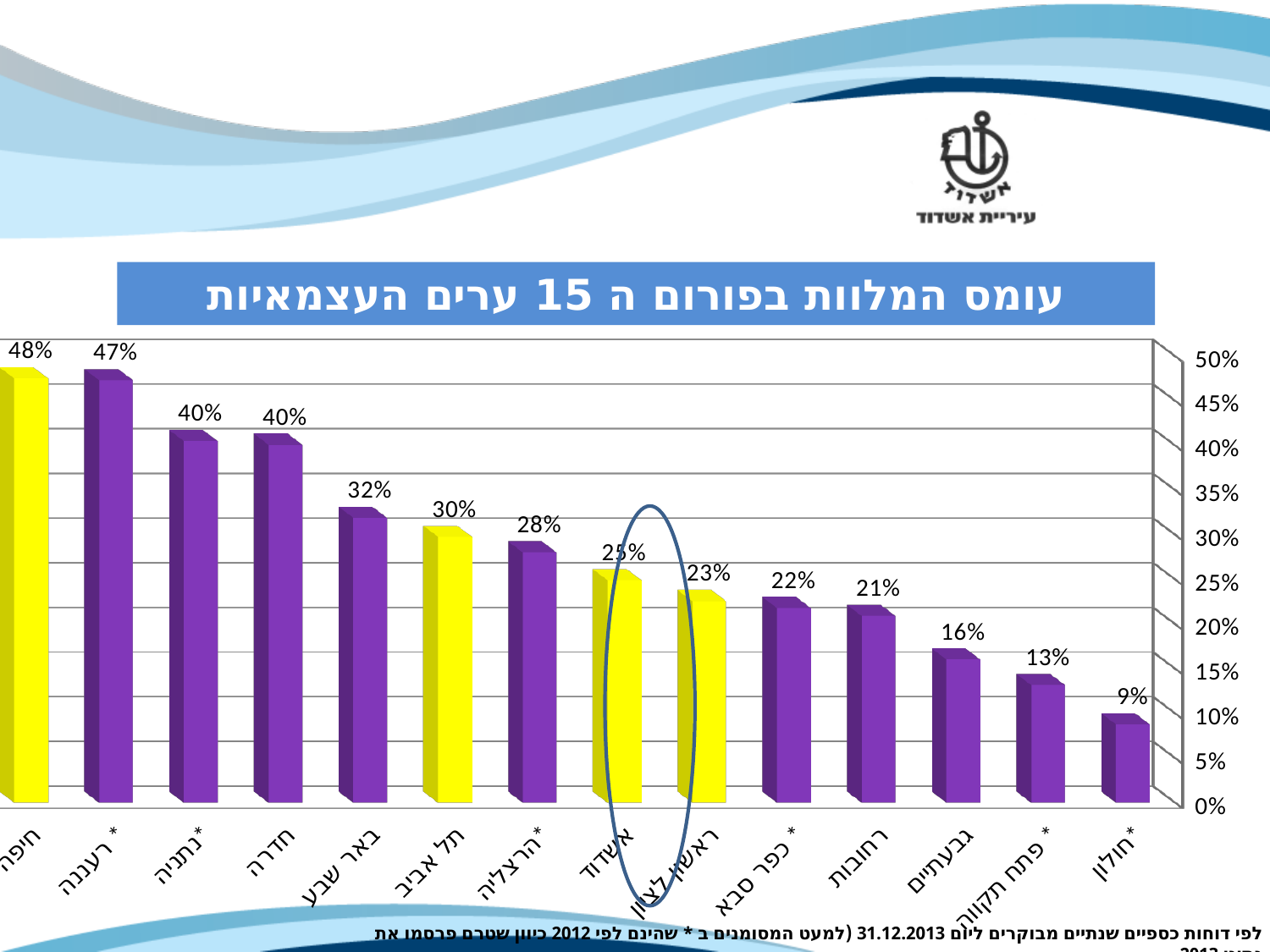
Is the value for פתח תקווה greater or less than 15%? less Which is larger, the value for הרצליה or the value for כפר סבא? הרצליה Which city has the lowest value on the chart? חולון What is the value for ראשון לציון? 23% What is the value for גבעתיים? 16% What is the value for חדרה? 40% What is the value for אשדוד? 25% What is the difference between the values for באר שבע and תל אביב? 2% Do the values rise or fall moving from left to right across the chart? fall What is the difference between the values for רעננה and חולון? 38% Which city's bar is circled on the chart? אשדוד What kind of chart is shown on the slide? bar chart